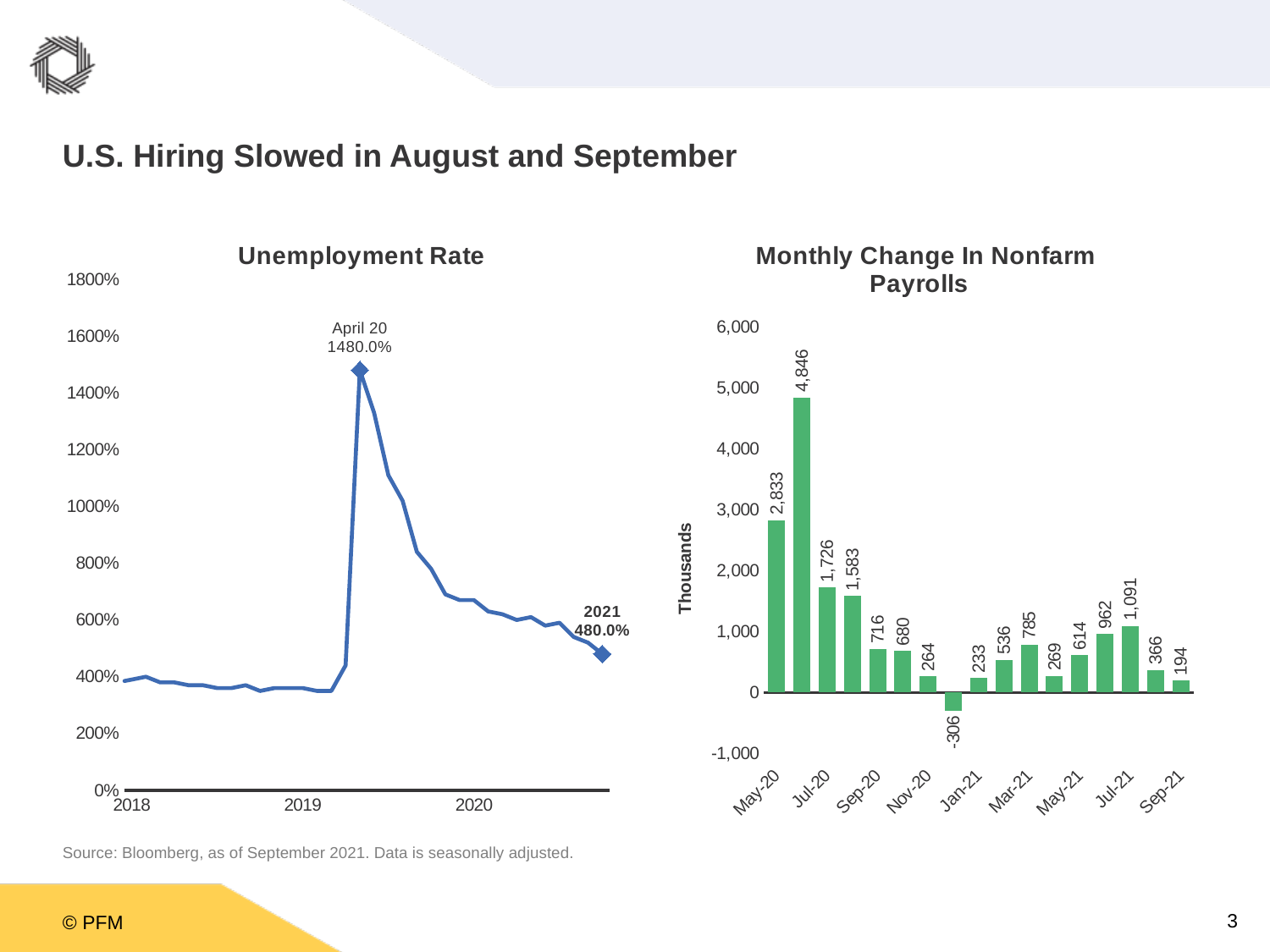
In the Unemployment Rate chart, what value is labeled for 2021? 480.0% In the Monthly Change In Nonfarm Payrolls chart, what is the difference between the Jul-21 value and the Sep-21 value? 897 What kind of chart is the Monthly Change In Nonfarm Payrolls chart? bar chart In the Monthly Change In Nonfarm Payrolls chart, what is the value for Sep-21? 194 What kind of chart is the Unemployment Rate chart? line chart In the Monthly Change In Nonfarm Payrolls chart, what is the value of the tallest bar? 4,846 How many bars are plotted in the Monthly Change In Nonfarm Payrolls chart? 17 In the Monthly Change In Nonfarm Payrolls chart, what is the lowest value shown? -306 In the Unemployment Rate chart, what is the difference between the April 20 value and the 2021 value? 1000.0% In the Monthly Change In Nonfarm Payrolls chart, what is the value for May-20? 2,833 In the Unemployment Rate chart, what value is labeled for April 20? 1480.0% In the Monthly Change In Nonfarm Payrolls chart, which is larger, the value for Mar-21 or the value for May-21? Mar-21